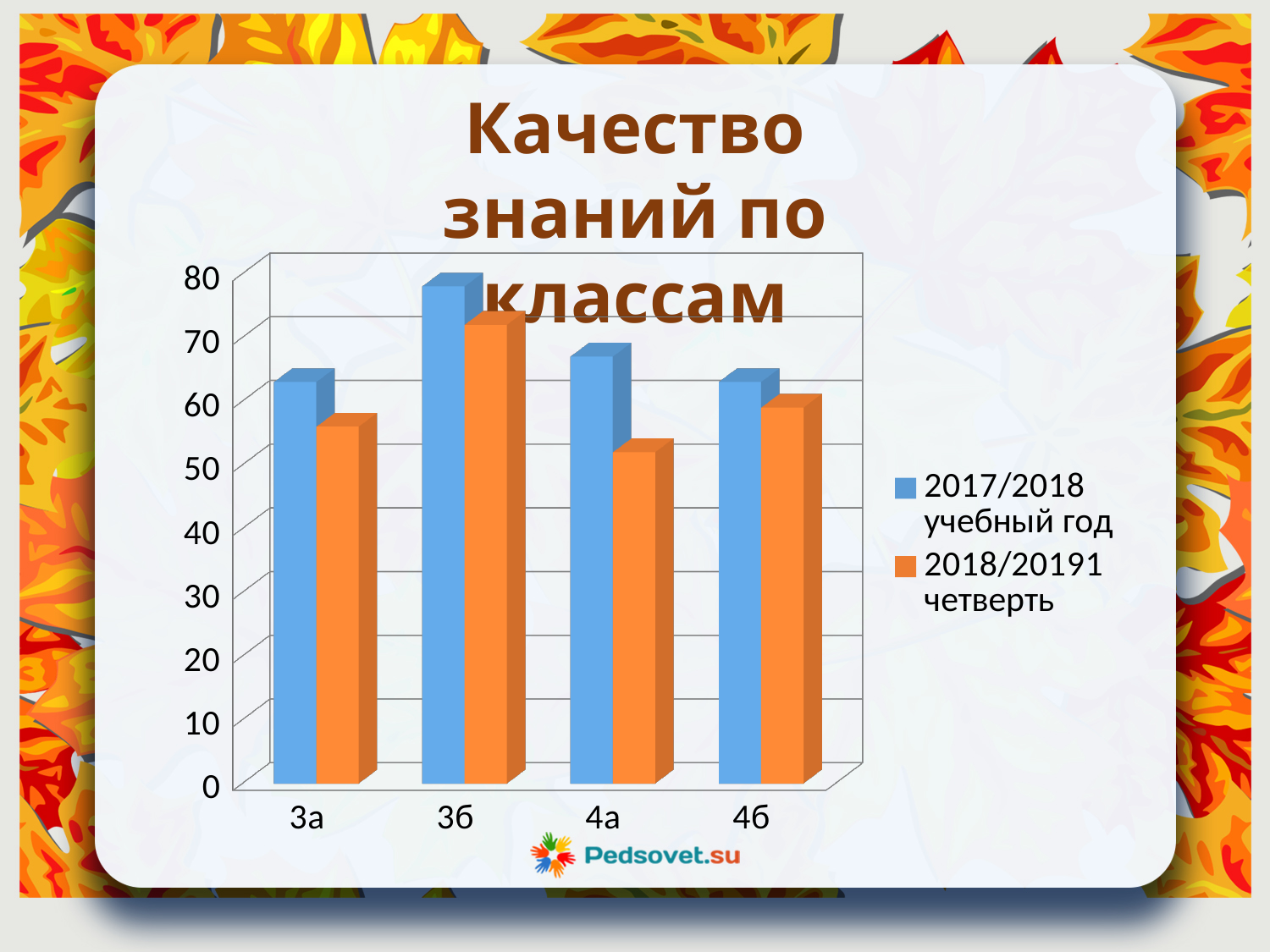
For class 4а, which series has the larger value: 2017/2018 учебный год or 2018/2019 1 четверть? 2017/2018 учебный год How many series does the legend list? 2 Is the 2017/2018 учебный год value for 4а greater or less than 70? less Which class has the lowest value for the 2018/2019 1 четверть series? 4а What is the title of the chart? Качество знаний по классам Which class has the highest value for the 2018/2019 1 четверть series? 3б Which class has the highest value for the 2017/2018 учебный год series? 3б How many classes (categories) are shown on the x axis? 4 Is the 2017/2018 учебный год value for 3б greater or less than 70? greater What kind of chart is shown on the slide? bar chart Is the 2018/2019 1 четверть value for 3а greater or less than 60? less Which colour represents the 2018/2019 1 четверть series? orange